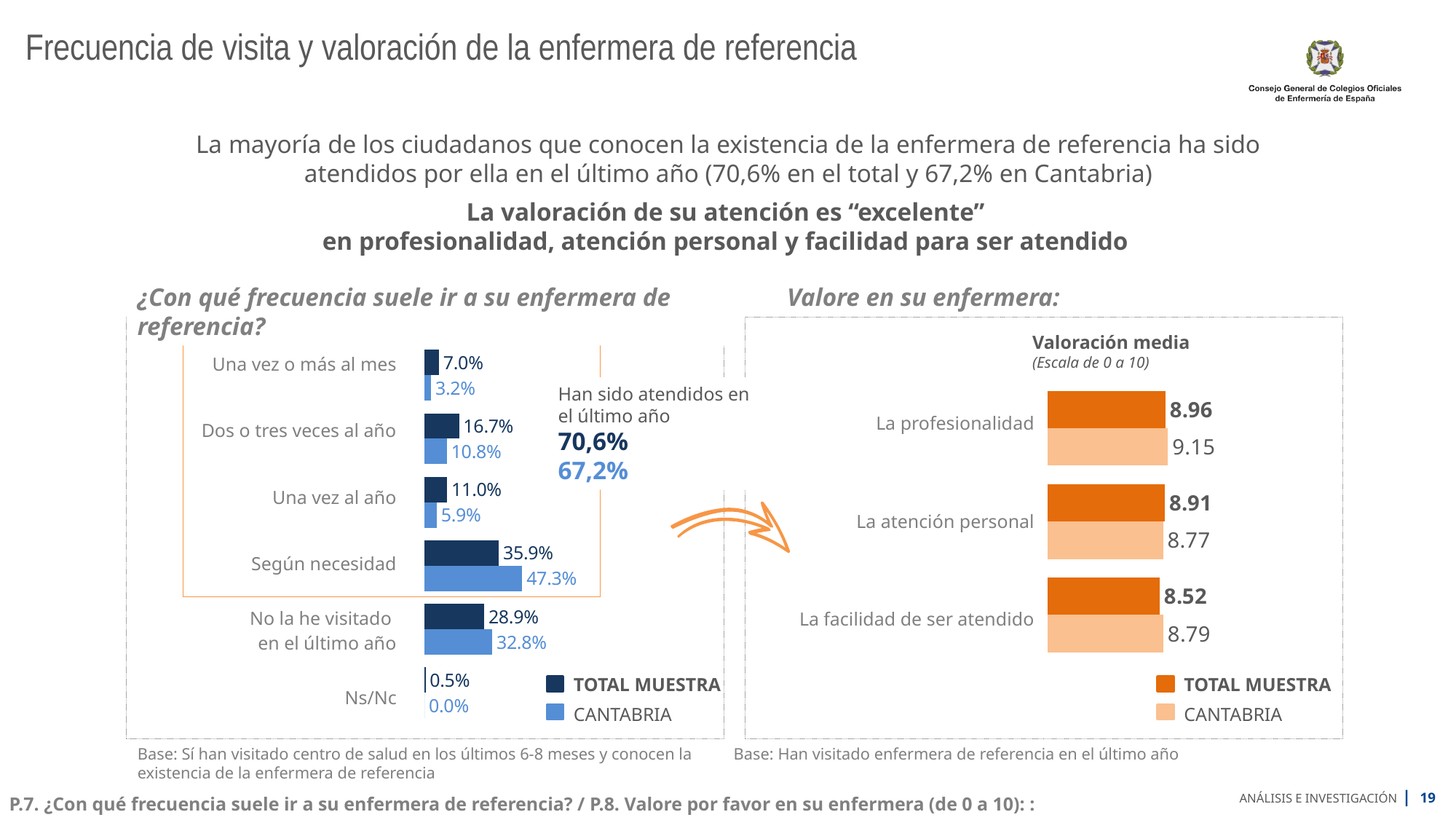
In the left chart (¿Con qué frecuencia suele ir a su enfermera de referencia?), which is larger for 'Una vez al año': TOTAL MUESTRA or CANTABRIA? TOTAL MUESTRA In the right chart (Valore en su enfermera), what is the difference between the CANTABRIA and TOTAL MUESTRA scores for 'La profesionalidad'? 0.19 In the left chart (¿Con qué frecuencia suele ir a su enfermera de referencia?), what is the difference between the CANTABRIA and TOTAL MUESTRA values for 'Según necesidad'? 11.4% In the right chart (Valore en su enfermera), what is the TOTAL MUESTRA score for 'La profesionalidad'? 8.96 In the left chart (¿Con qué frecuencia suele ir a su enfermera de referencia?), what is the TOTAL MUESTRA value for 'Según necesidad'? 35.9% In the right chart (Valore en su enfermera), what is the CANTABRIA score for 'La facilidad de ser atendido'? 8.79 In the left chart (¿Con qué frecuencia suele ir a su enfermera de referencia?), which category has the highest CANTABRIA value? Según necesidad In the left chart (¿Con qué frecuencia suele ir a su enfermera de referencia?), which category has the lowest TOTAL MUESTRA value? Ns/Nc How many categories are shown in the left chart (¿Con qué frecuencia suele ir a su enfermera de referencia?)? 6 In the left chart (¿Con qué frecuencia suele ir a su enfermera de referencia?), what is the CANTABRIA value for 'Dos o tres veces al año'? 10.8% In the right chart (Valore en su enfermera), which aspect has the lowest TOTAL MUESTRA score? La facilidad de ser atendido How many series does the legend of the right chart (Valore en su enfermera) list? 2